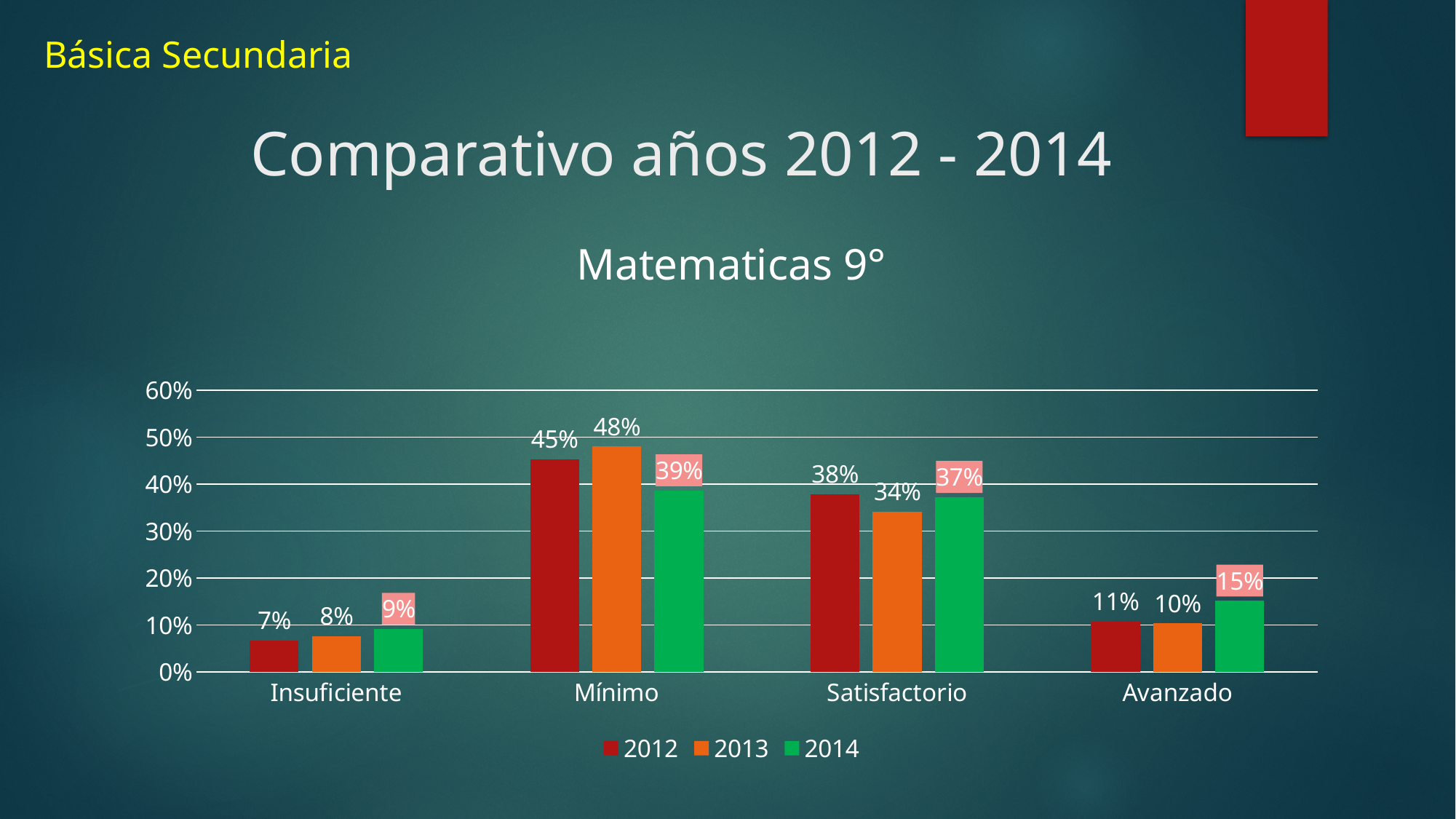
Is the value for 2014 in the Avanzado category greater or less than 20%? less Which category has the lowest value for 2012? Insuficiente How many categories are shown on the x axis? 4 How many series does the legend list? 3 What is the value for 2013 in the Avanzado category? 10% Which is larger in the Satisfactorio category, the 2012 value or the 2013 value? 2012 What is the value for 2014 in the Mínimo category? 39% What is the value for 2012 in the Satisfactorio category? 38% What is the title of the chart? Matematicas 9° Which category has the highest value for 2013? Mínimo What is the difference between the 2013 and 2014 values in the Mínimo category? 9% What kind of chart is shown on the slide? bar chart